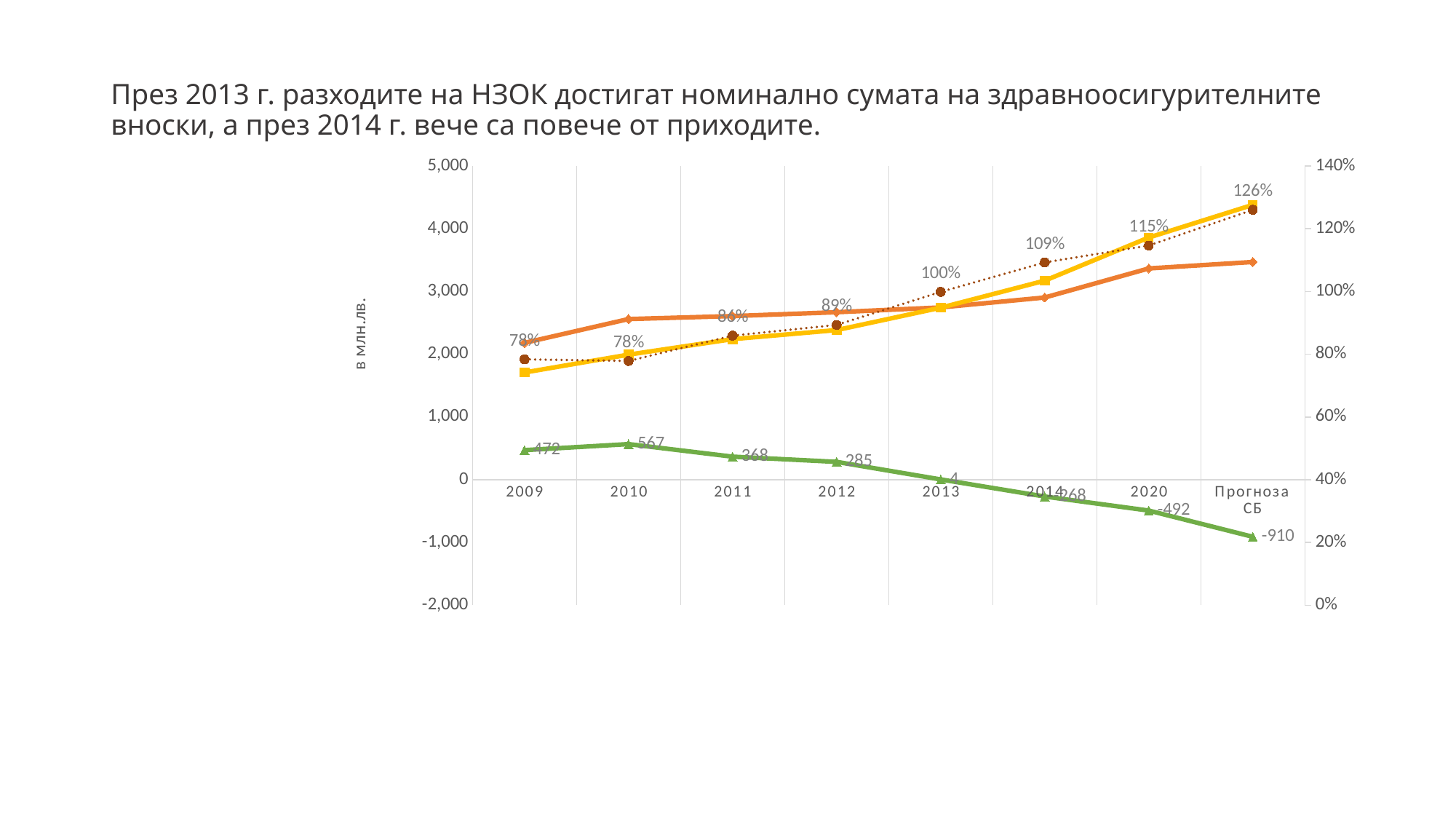
What is the title of the left vertical axis? в млн.лв. What kind of chart is shown on the slide? line chart What percentage is labelled on the dotted line for 2014? 109% In which category does the green line reach its highest value? 2010 Is the value of the orange line in 2009 greater or less than 2,000? greater What is the difference between the green line values for 2010 and 2009? 95 What percentage is labelled on the dotted line for 2013? 100% In which category does the green line reach its lowest value? Прогноза СБ What is the value of the green line for Прогноза СБ? -910 Does the dotted percentage line rise or fall from 2009 to Прогноза СБ? rise What is the value of the green line in 2010? 567 How many categories are shown along the x axis? 8